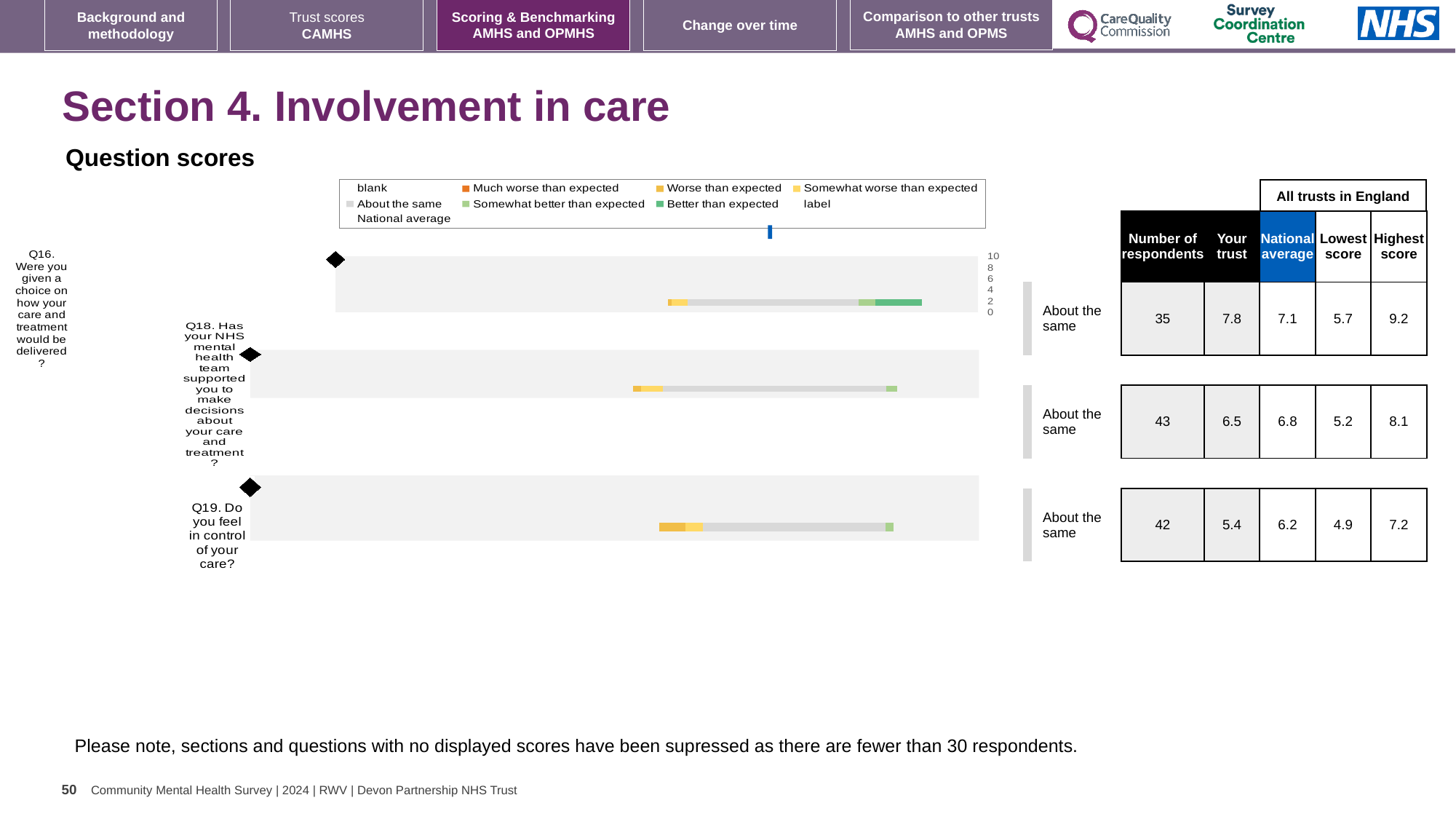
Which question has the highest 'Your trust' score in the table beside the chart? Q16 What is the difference between the 'Your trust' score and the national average for Q16? 0.7 What is the highest value shown on the chart's numeric axis? 10 Which question has the lowest 'Your trust' score in the table beside the chart? Q19 What kind of chart is used to show the question scores on this slide? bar chart How many entries does the legend of the question scores chart list? 9 What benchmark label is shown next to each of the three questions in the chart? About the same For Q18, which is larger: the 'Your trust' score or the national average? National average According to the table beside the chart, what is the national average for Q19 (feeling in control of your care)? 6.2 According to the table beside the chart, how many respondents answered Q18? 43 According to the table beside the chart, what is the 'Your trust' score for Q16 (choice on how care and treatment would be delivered)? 7.8 How many questions (categories) are plotted in the question scores chart? 3